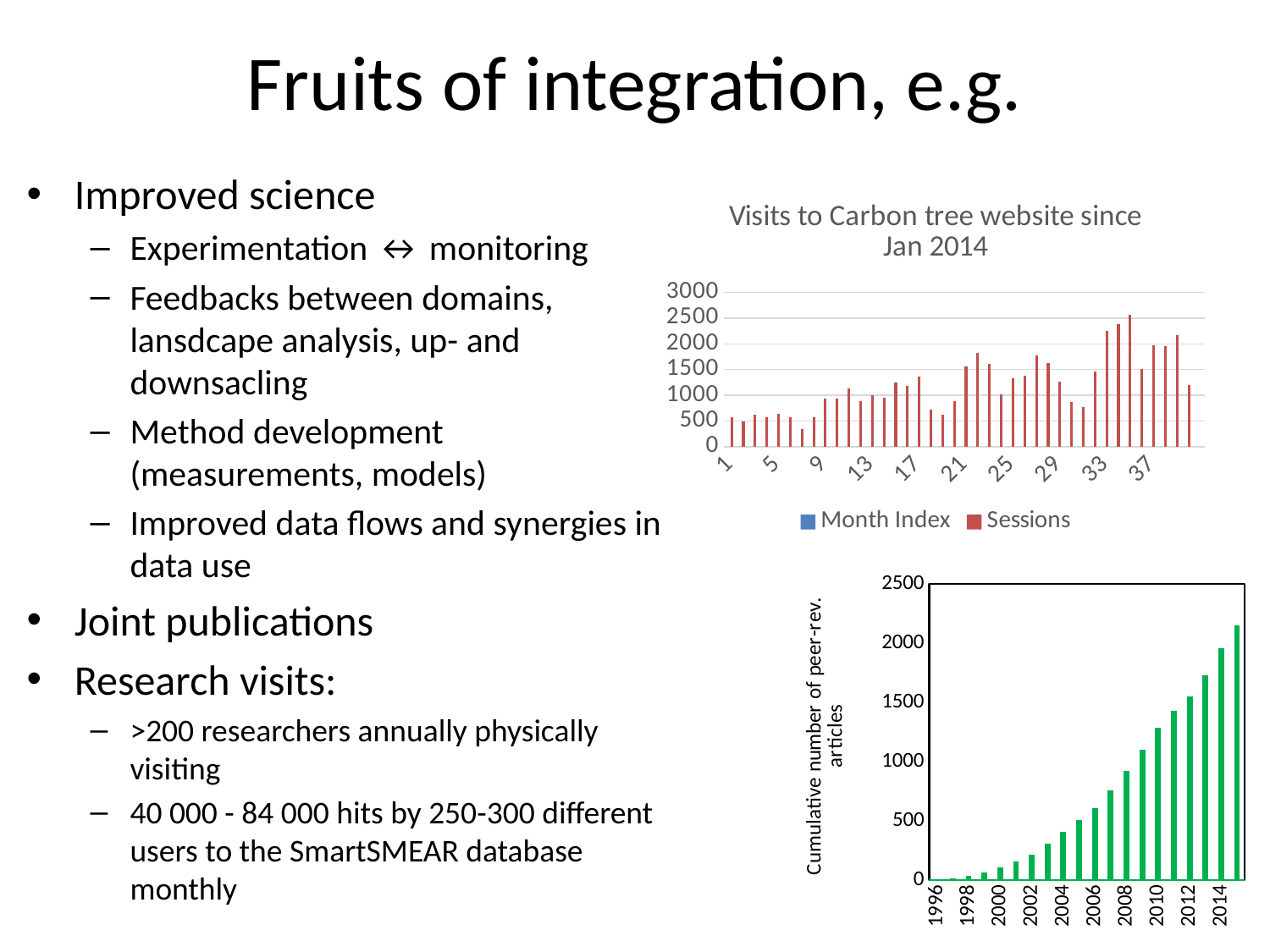
In the 'Visits to Carbon tree website since Jan 2014' chart, is the value for month 21 greater or less than 1000? greater In the 'Visits to Carbon tree website since Jan 2014' chart, is the value for month 1 greater or less than 1000? less What is the y-axis label of the bottom-right chart? Cumulative number of peer-rev. articles How many series does the legend of the 'Visits to Carbon tree website since Jan 2014' chart list? 2 In the bottom-right chart of cumulative peer-reviewed articles, is the value for 2000 greater or less than 500? less What are the two legend entries on the 'Visits to Carbon tree website since Jan 2014' chart? Month Index and Sessions What kind of chart is the 'Visits to Carbon tree website since Jan 2014' chart? bar chart What kind of chart is the bottom-right chart showing the cumulative number of peer-reviewed articles? bar chart In the bottom-right chart of cumulative peer-reviewed articles, do the values rise or fall from 1996 to 2014? rise